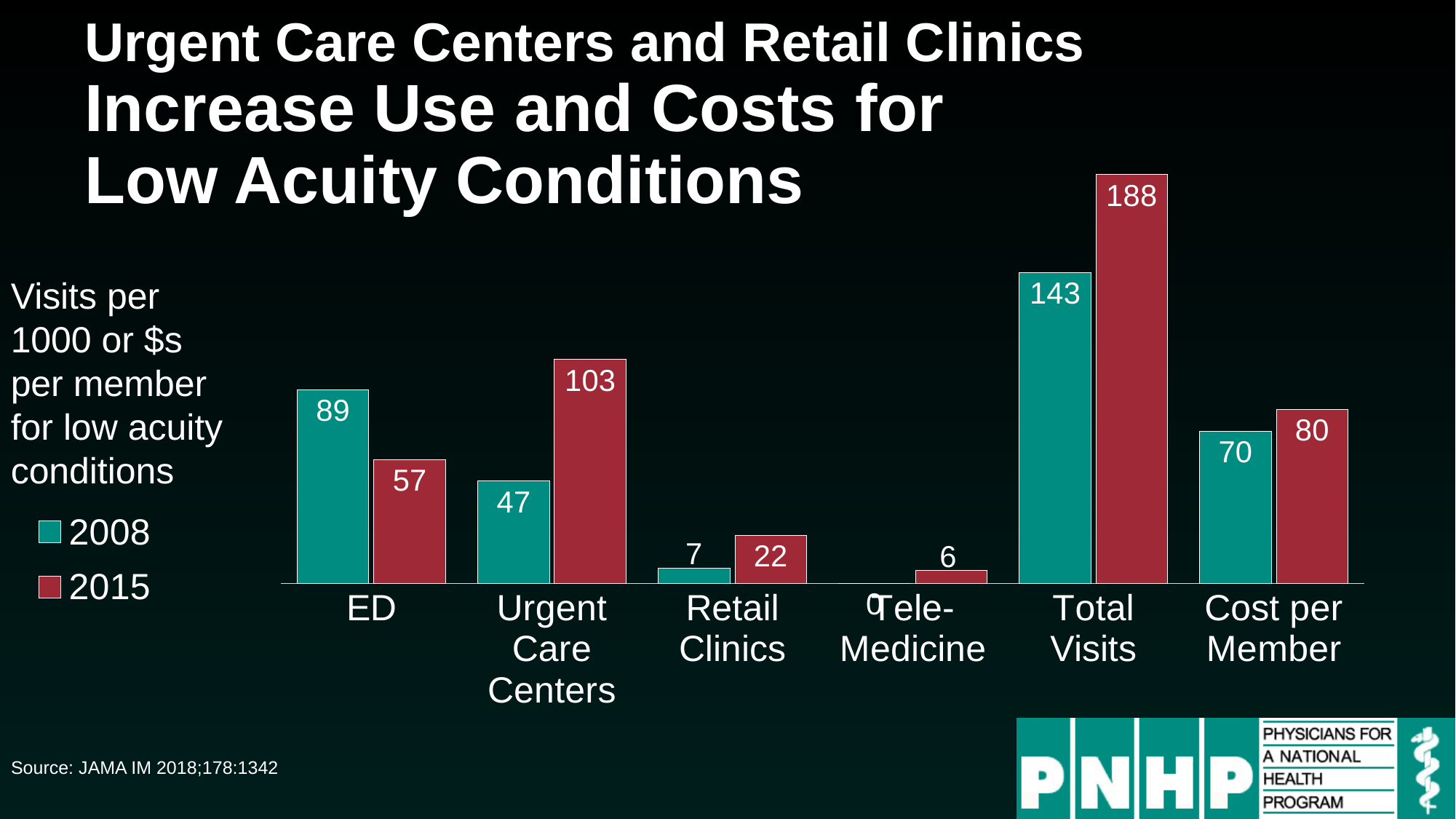
What kind of chart is shown on the slide? Bar chart What is the difference between the 2008 and 2015 values for ED? 32 How many series does the legend list? 2 For ED, which year has the larger value, 2008 or 2015? 2008 Which category has the highest 2015 value? Total Visits What is the 2015 value for Total Visits? 188 How many categories are shown on the x axis? 6 What is the difference between the 2015 and 2008 values for Urgent Care Centers? 56 What is the 2015 value for Retail Clinics? 22 What is the 2008 value for Urgent Care Centers? 47 What is the 2008 value for Cost per Member? 70 Which category has the lowest 2015 value? Tele-Medicine